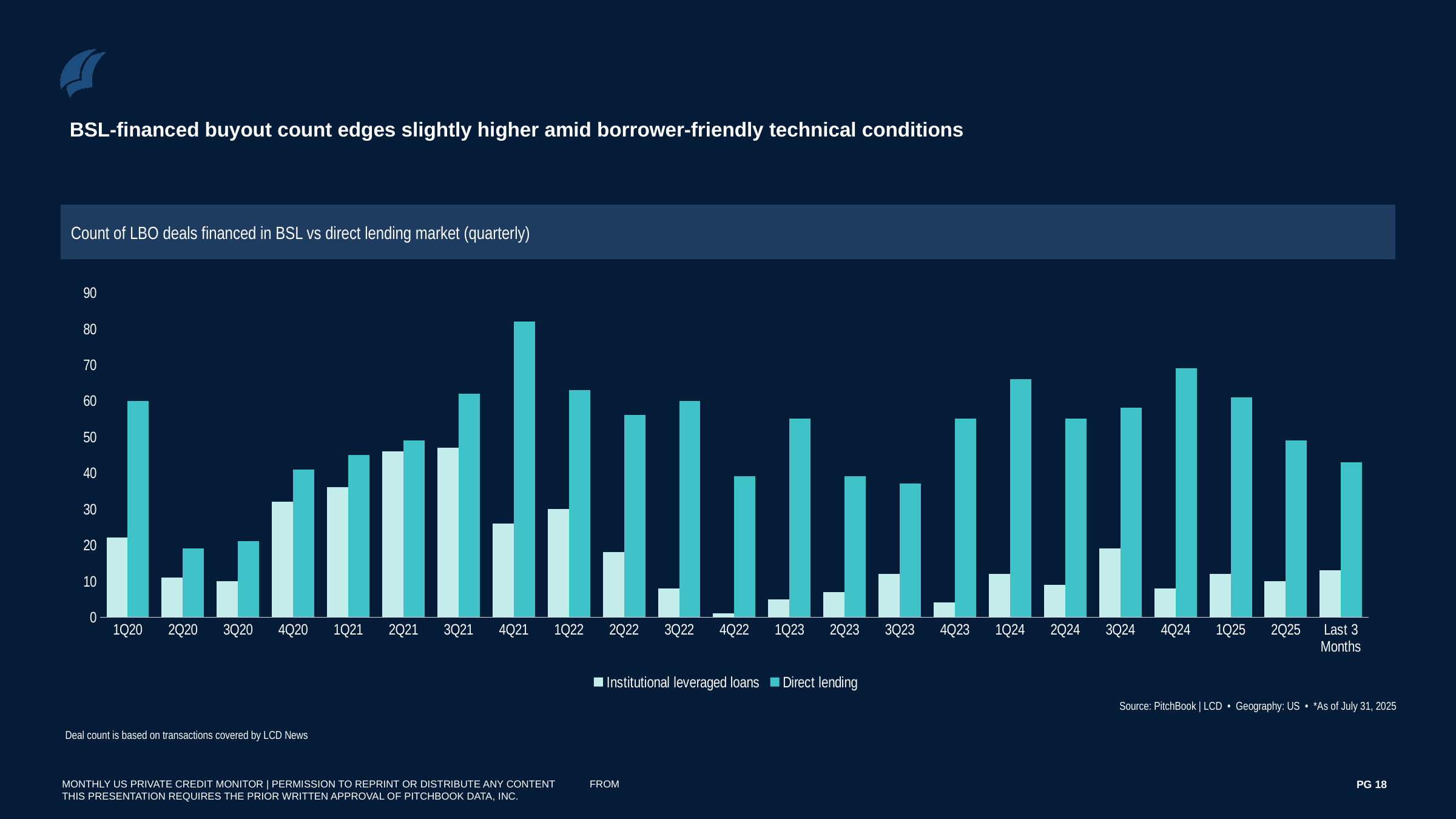
Is the Institutional leveraged loans value for 4Q22 greater or less than 10? less Is the Direct lending value for 4Q21 greater or less than 70? greater In which period is the Direct lending deal count highest? 4Q21 Which is larger in 1Q20: the Institutional leveraged loans count or the Direct lending count? Direct lending Is the Direct lending value for 4Q24 greater or less than 60? greater What kind of chart is shown on the slide? Bar chart Which period has the larger Institutional leveraged loans count: 3Q21 or 4Q21? 3Q21 What are the two series named in the legend? Institutional leveraged loans and Direct lending How many quarterly periods (categories) are shown along the x axis, including 'Last 3 Months'? 23 In which period is the Institutional leveraged loans deal count lowest? 4Q22 Does the Direct lending deal count rise or fall from 2Q20 to 4Q21? rise How many series does the legend list? 2